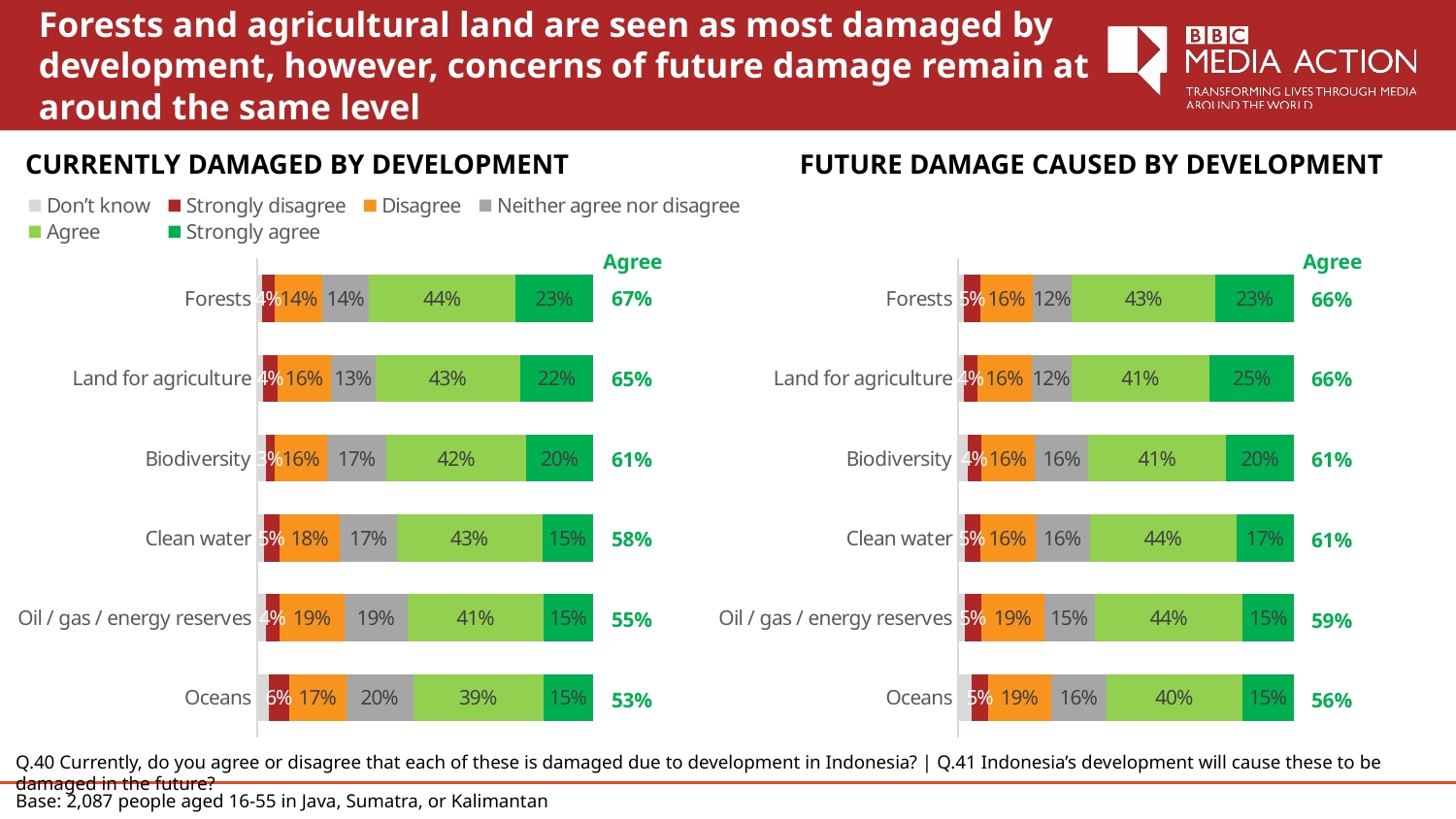
In the 'Currently damaged by development' chart, which category has the highest combined Agree total shown at the right? Forests What kind of chart is the 'Future damage caused by development' chart? Stacked bar chart In the 'Future damage caused by development' chart, what is the Disagree percentage for Oil / gas / energy reserves? 19% In the 'Future damage caused by development' chart, which category has the lowest combined Agree total shown at the right? Oceans How many series does the legend list? 6 In the 'Currently damaged by development' chart, what is the difference between the combined Agree totals for Forests and Oceans? 14% What is the title of the chart on the left of the slide? CURRENTLY DAMAGED BY DEVELOPMENT In the 'Currently damaged by development' chart, what is the Neither agree nor disagree percentage for Oceans? 20% How many categories are shown in the 'Currently damaged by development' chart? 6 In the 'Currently damaged by development' chart, what is the Agree percentage for Forests? 44% In the 'Future damage caused by development' chart, which is larger: the Agree percentage for Clean water or for Oceans? Clean water In the 'Future damage caused by development' chart, what is the Strongly agree percentage for Land for agriculture? 25%